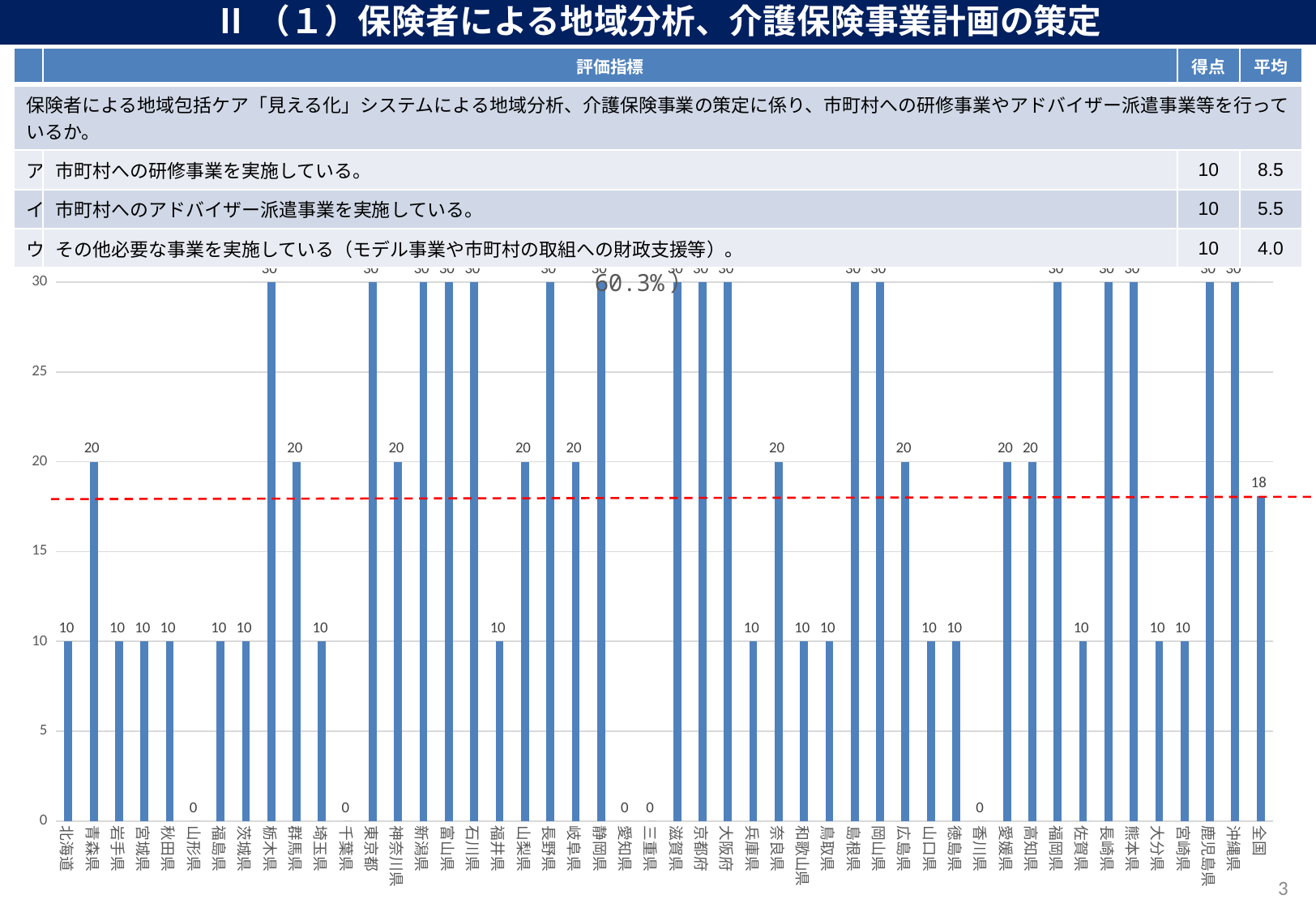
What is the difference between the values for 沖縄県 and 全国? 12 Is the value for 全国 greater or less than 20? less What is the value for 沖縄県 in the bar chart? 30 What is the value for 全国 in the bar chart? 18 How many categories are plotted on the x axis of the bar chart? 48 What is the value for 栃木県 in the bar chart? 30 What is the difference between the values for 栃木県 and 北海道? 20 What is the value for 山形県 in the bar chart? 0 What is the value for 青森県 in the bar chart? 20 Which has the larger value, 青森県 or 岩手県? 青森県 How many categories in the bar chart have a value of 0? 5 What kind of chart is shown on the slide? bar chart